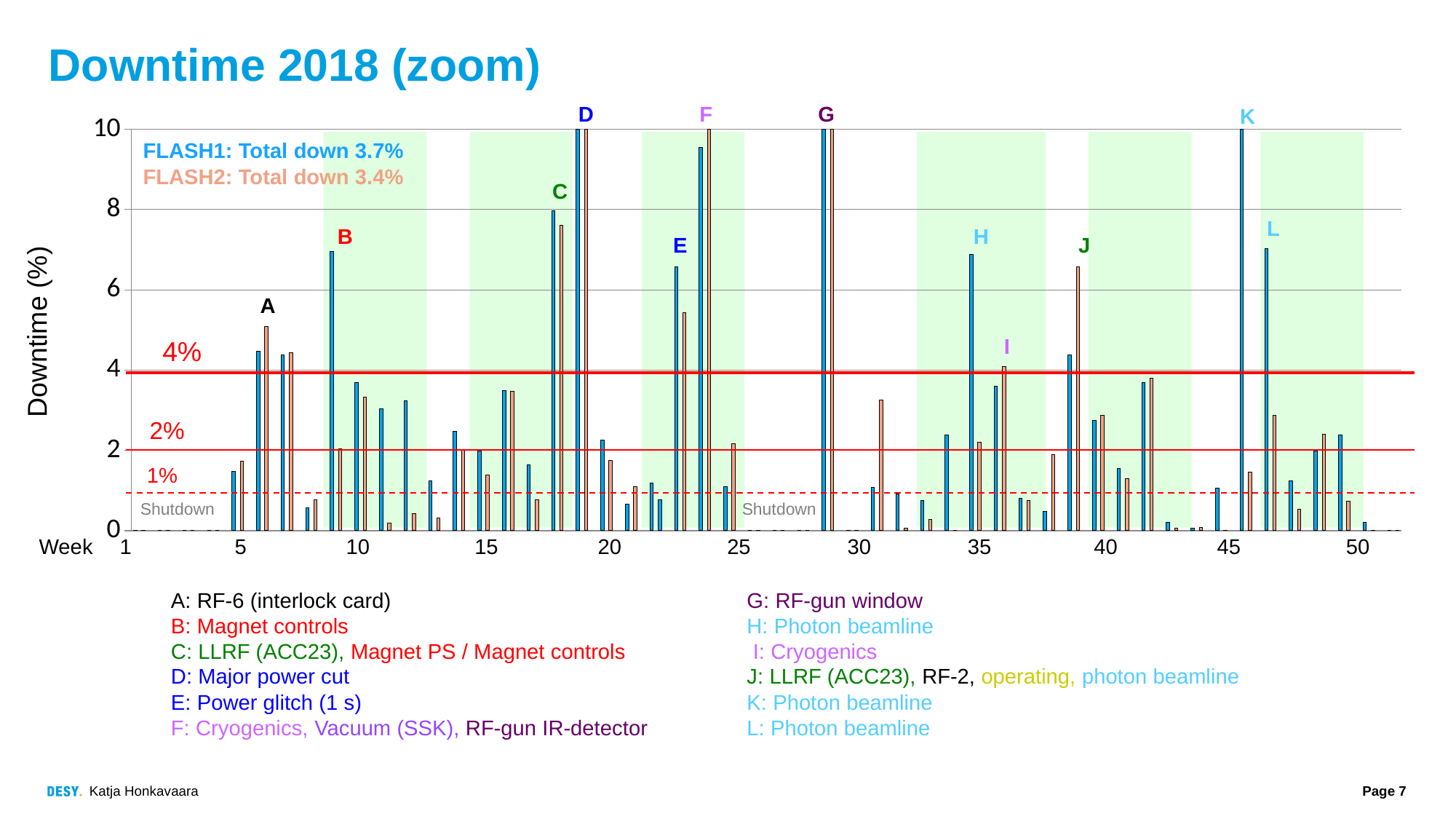
Is the FLASH1 (blue) downtime value at week 35 (event H) greater or less than 6? greater Is the FLASH1 (blue) downtime value at week 10 greater or less than 4? less Is the FLASH1 (blue) downtime value at week 9 (event B) greater or less than 6? greater What is the difference between the stated total downtime of FLASH1 and FLASH2? 0.3% What kind of chart is shown on the slide? bar chart At week 39 (event J), which bar is taller, the FLASH1 (blue) bar or the FLASH2 (orange) bar? FLASH2 (orange) What total downtime is stated for FLASH1? 3.7% At week 46 (event L), which bar is taller, the FLASH1 (blue) bar or the FLASH2 (orange) bar? FLASH1 (blue) What is the label of the y axis? Downtime (%) What total downtime is stated for FLASH2? 3.4% Which has the larger stated total downtime, FLASH1 or FLASH2? FLASH1 What is the title of the chart? Downtime 2018 (zoom)